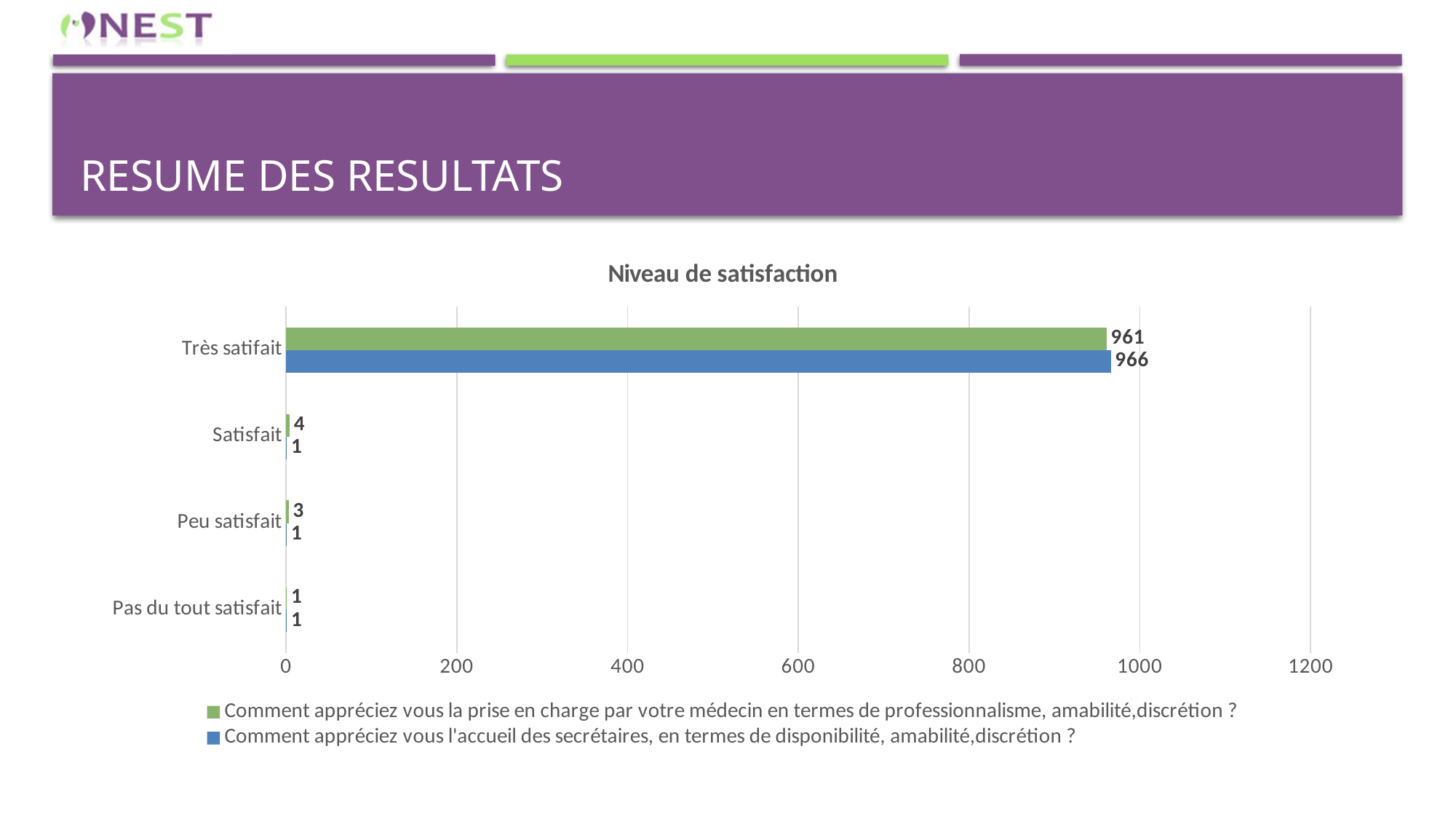
What is the value for 'Satisfait' in the series about the médecin (green)? 4 Which category has the highest value in the series about the accueil des secrétaires (blue)? Très satifait How many satisfaction categories are shown on the chart? 4 What is the value for 'Peu satisfait' in the series about the médecin (green)? 3 Is the value for 'Très satifait' in the médecin series (green) greater or less than 800? greater How many series does the legend list? 2 What type of chart is shown on the slide? Bar chart What is the value for 'Très satifait' in the series about the accueil des secrétaires (blue)? 966 What is the value for 'Pas du tout satisfait' in the series about the accueil des secrétaires (blue)? 1 What is the title of the chart? Niveau de satisfaction What is the difference between the 'Très satifait' values of the two series (966 and 961)? 5 What is the value for 'Très satifait' in the series about the médecin (green)? 961